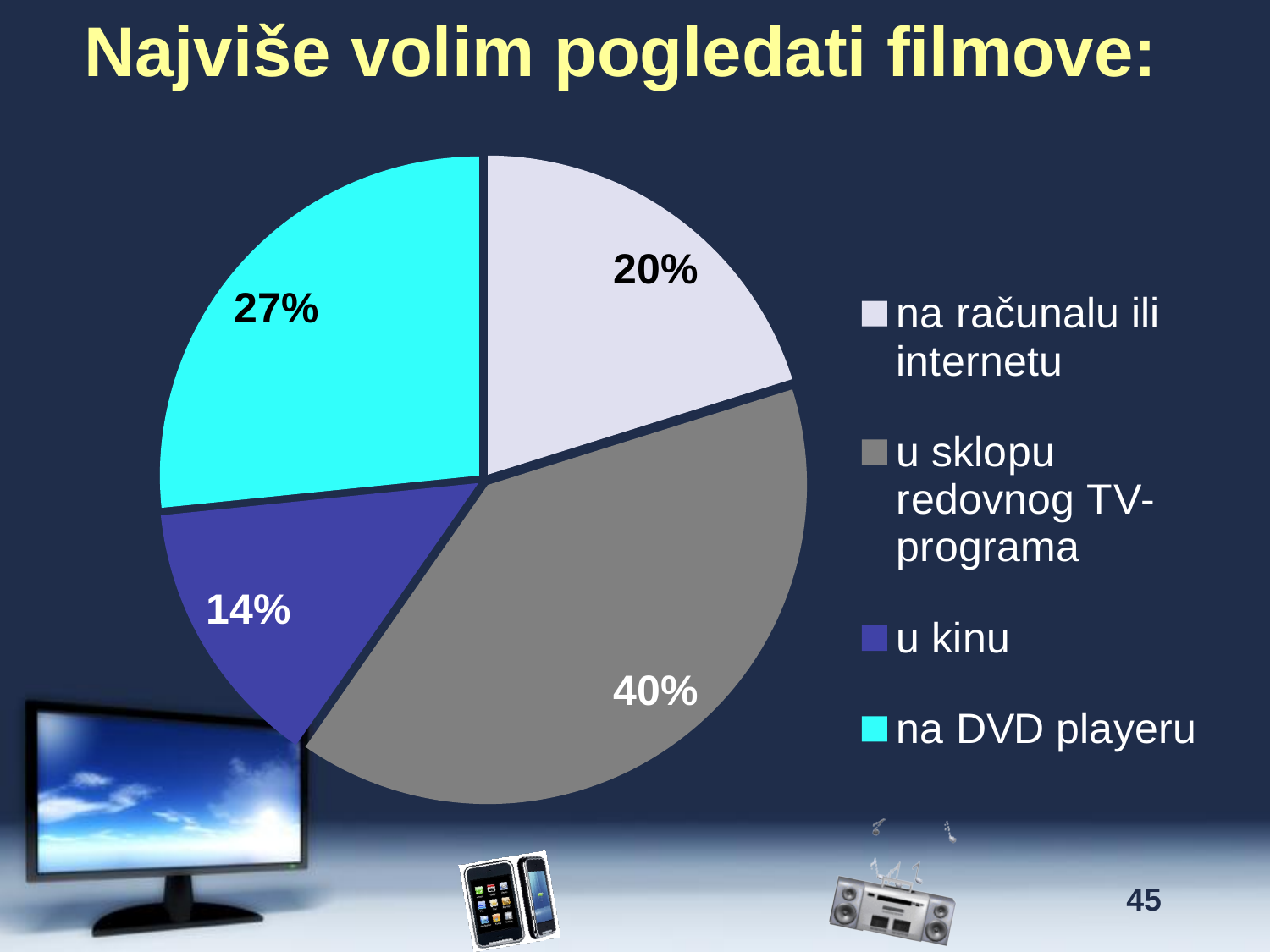
What percentage of the pie is for "na DVD playeru"? 27% Which is larger: the share for "na DVD playeru" or the share for "na računalu ili internetu"? na DVD playeru What percentage of the pie is for "na računalu ili internetu"? 20% What is the title of the slide? Najviše volim pogledati filmove: Which category has the smallest slice of the pie? u kinu How many categories does the pie chart have? 4 What colour is the slice for "u kinu"? blue What is the difference between the shares for "u sklopu redovnog TV-programa" and "na DVD playeru"? 13% What kind of chart is shown on the slide? pie chart Which category has the largest slice of the pie? u sklopu redovnog TV-programa What percentage of the pie is for "u sklopu redovnog TV-programa"? 40% What percentage of the pie is for "u kinu"? 14%